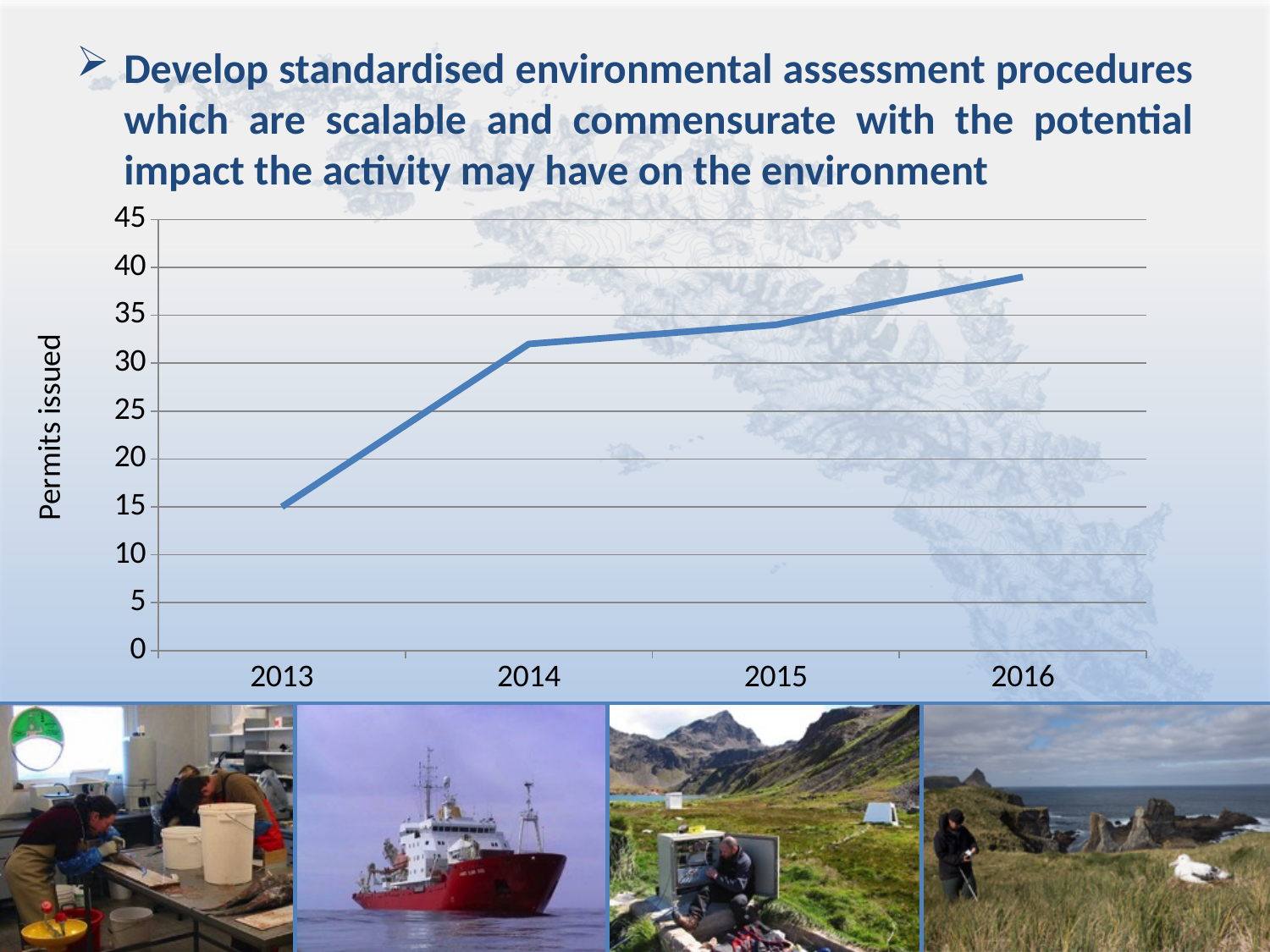
What kind of chart is shown on the slide? line chart Which year has the lowest number of permits issued? 2013 Is the value for 2014 greater or less than 35? less Which year has more permits issued, 2013 or 2016? 2016 Do the values in the chart rise or fall from 2013 to 2016? rise How many years are plotted on the x axis of the chart? 4 Is the value for 2014 greater or less than 30? greater Is the value for 2016 greater or less than 35? greater Which year has the highest number of permits issued? 2016 How many permits were issued in 2013? 15 What is the label on the vertical axis of the chart? Permits issued